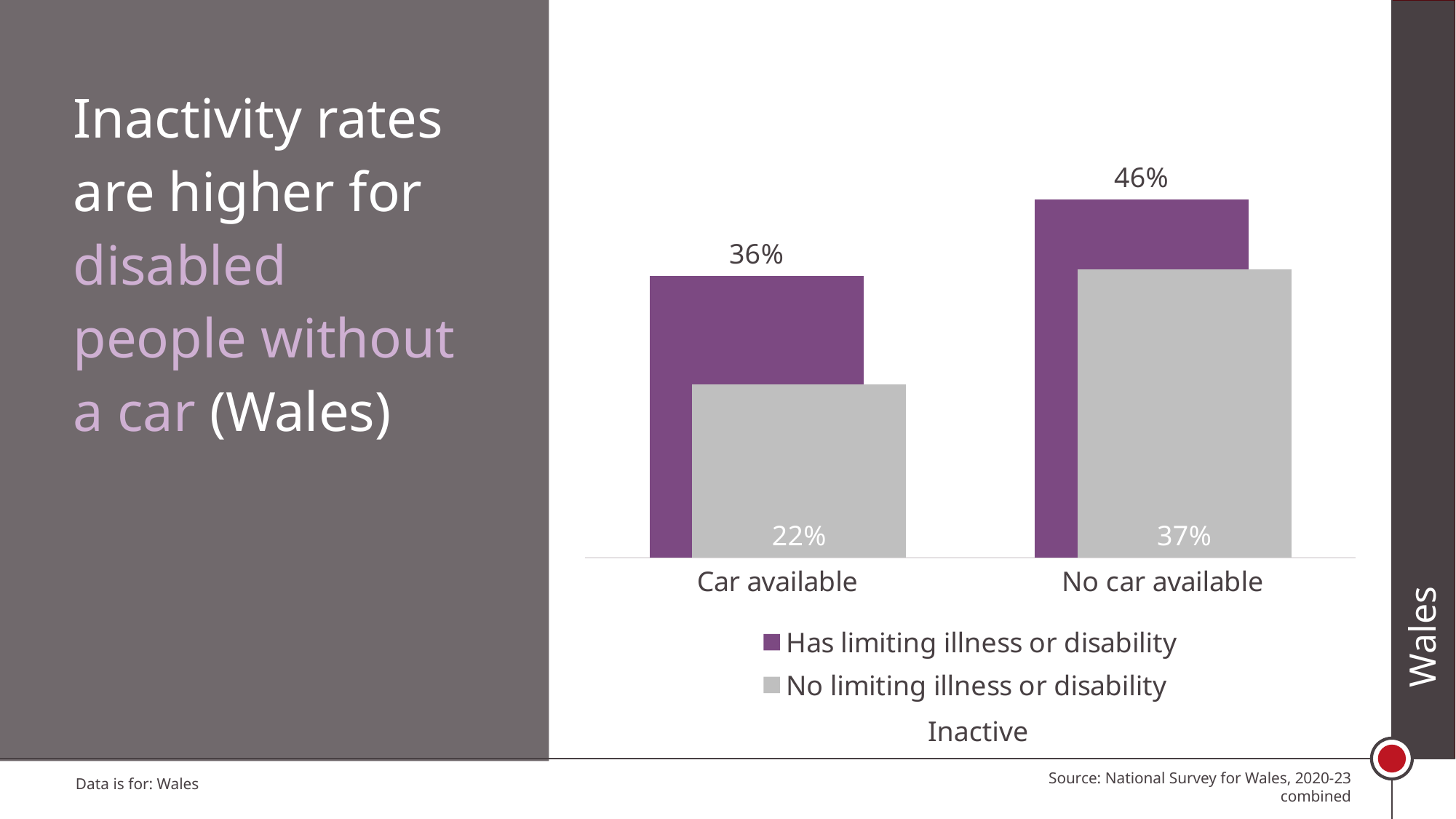
Is the inactivity rate higher for people with a limiting illness or disability with a car available, or for people with no limiting illness or disability with no car available? No limiting illness or disability with no car available Which category has the highest inactivity rate for people with a limiting illness or disability? No car available What is the difference in inactivity rate between people with and without a limiting illness or disability when no car is available? 9 percentage points Which bar shows the lowest inactivity rate on the chart? No limiting illness or disability, Car available What is the inactivity rate for people with no limiting illness or disability who have a car available? 22% How many series does the chart legend list? 2 What is the inactivity rate for people with no limiting illness or disability who have no car available? 37% How many categories are shown on the x axis of the chart? 2 What type of chart is shown on the slide? Bar chart What is the inactivity rate for people with a limiting illness or disability who have a car available? 36% What is the inactivity rate for people with a limiting illness or disability who have no car available? 46% What is the difference in inactivity rate for people with a limiting illness or disability between no car available and car available? 10 percentage points